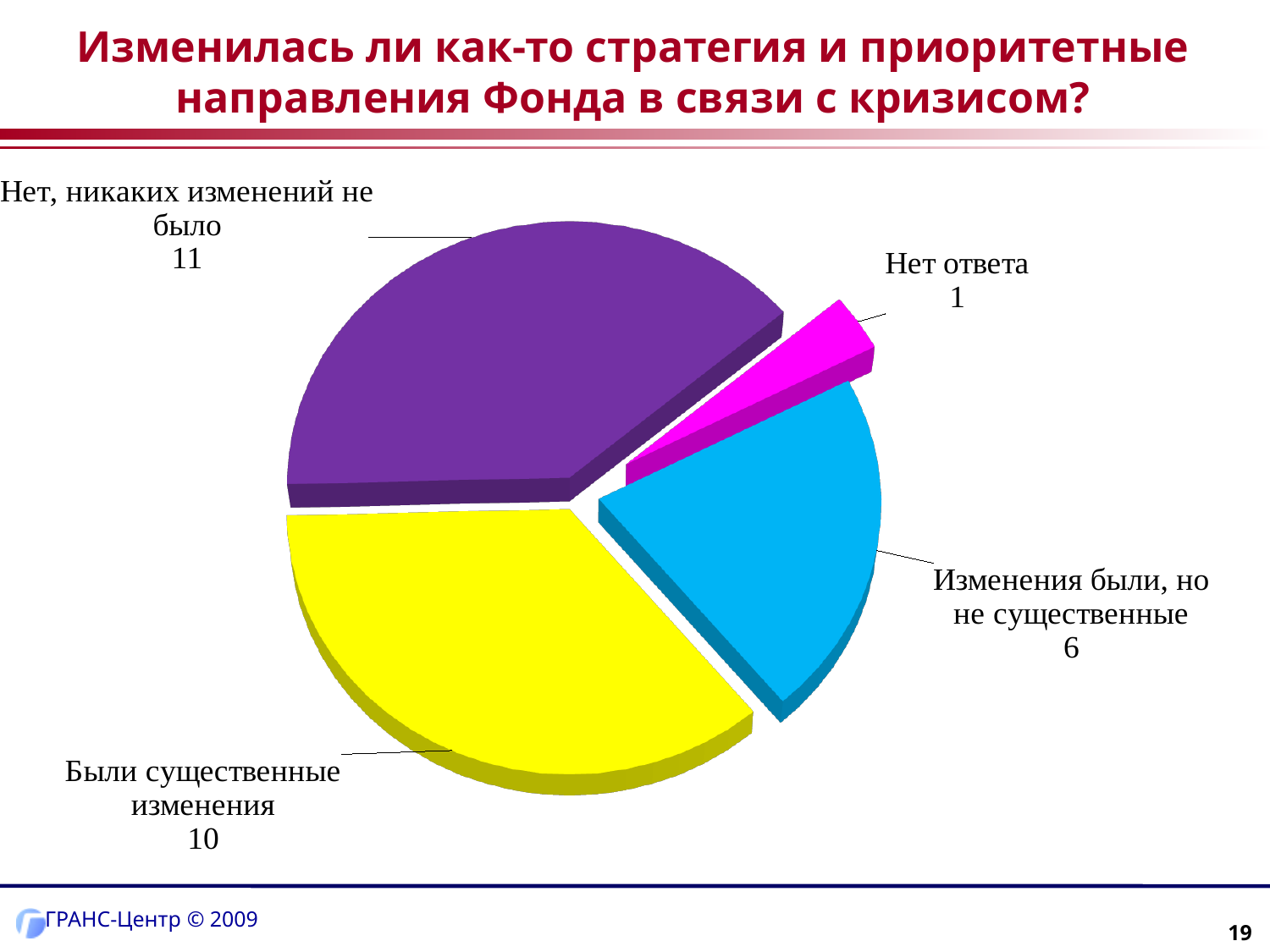
What is the value for "Нет ответа"? 1 How many slices does the pie chart have? 4 What is the total of all slices in the pie chart? 28 Which category has the smallest slice? Нет ответа What is the value for "Были существенные изменения"? 10 Which category has the largest slice? Нет, никаких изменений не было What is the difference between "Нет, никаких изменений не было" and "Изменения были, но не существенные"? 5 What kind of chart is shown on the slide? pie chart Which is larger: "Были существенные изменения" or "Изменения были, но не существенные"? Были существенные изменения What is the value for "Нет, никаких изменений не было"? 11 What is the value for "Изменения были, но не существенные"? 6 What colour is the slice for "Были существенные изменения"? yellow